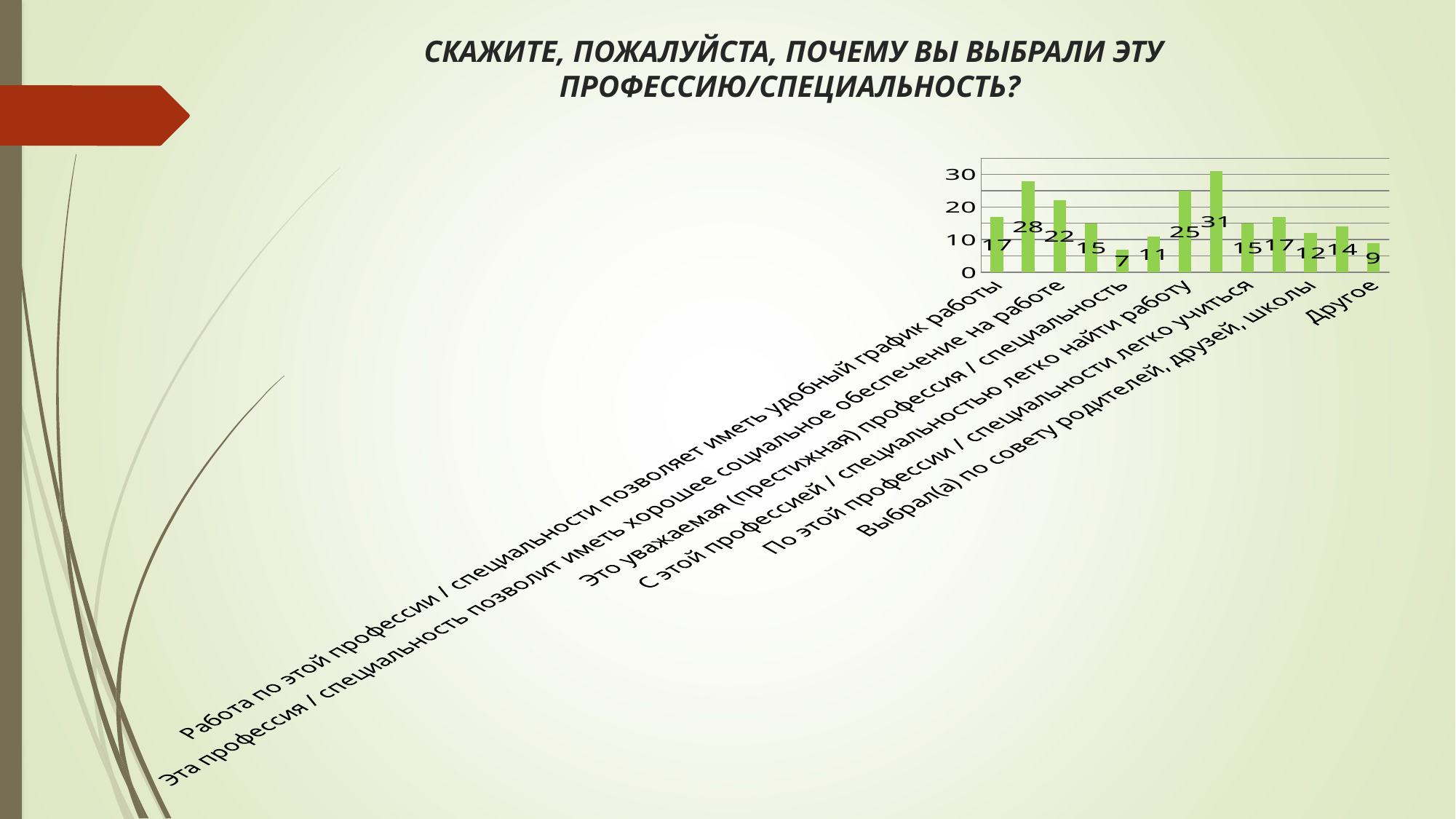
What kind of chart is shown on the slide? bar chart Which is larger, the value for the first category (17) or the value for "Другое" (9)? the first category (17) What is the difference between the highest value (31) and the lowest value (7) in the chart? 24 Is the value for the first category ("...удобный график работы") greater or less than 10? greater What is the highest value shown in the chart? 31 What colour are the bars in the chart? green What is the value for the first category, "Работа по этой профессии / специальности позволяет иметь удобный график работы"? 17 What is the lowest value shown in the chart? 7 What is the highest tick value shown on the vertical axis? 30 Is the value for "Другое" greater or less than 10? less What is the value for the category "Другое"? 9 How many bars are plotted in the chart? 13